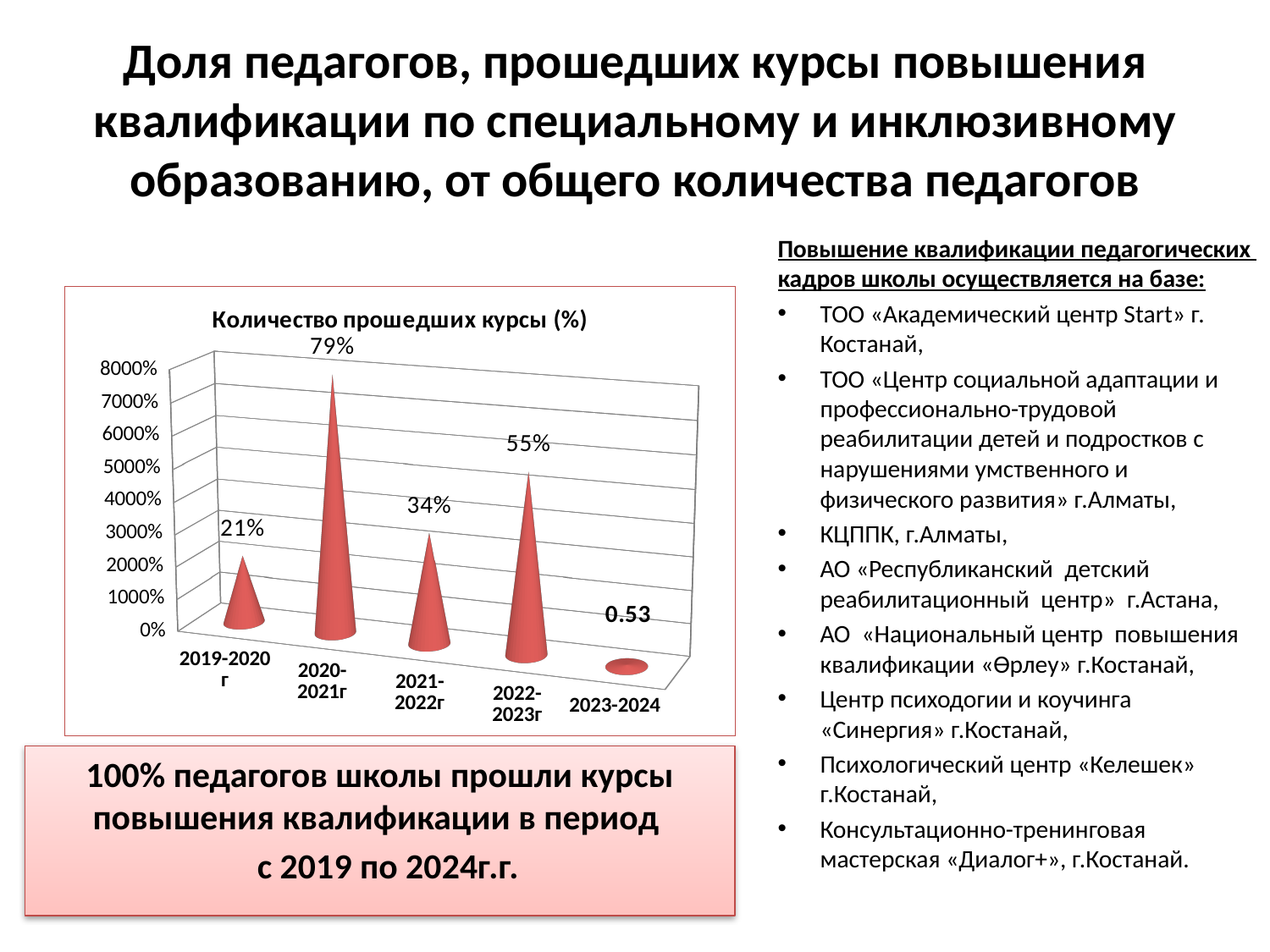
What is the title of the chart? Количество прошедших курсы (%) What is the value for 2022-2023г? 55% What is the value for 2021-2022г? 34% Which period has the highest value? 2020-2021г What kind of chart is this? bar chart Which is larger, the value for 2021-2022г or the value for 2022-2023г? 2022-2023г Which period has the lowest value? 2023-2024 How many periods are shown on the x axis? 5 What is the difference between the values for 2020-2021г and 2022-2023г? 24% What is the value shown for 2023-2024? 0.53 What is the value for 2020-2021г? 79% What is the value for 2019-2020 г? 21%